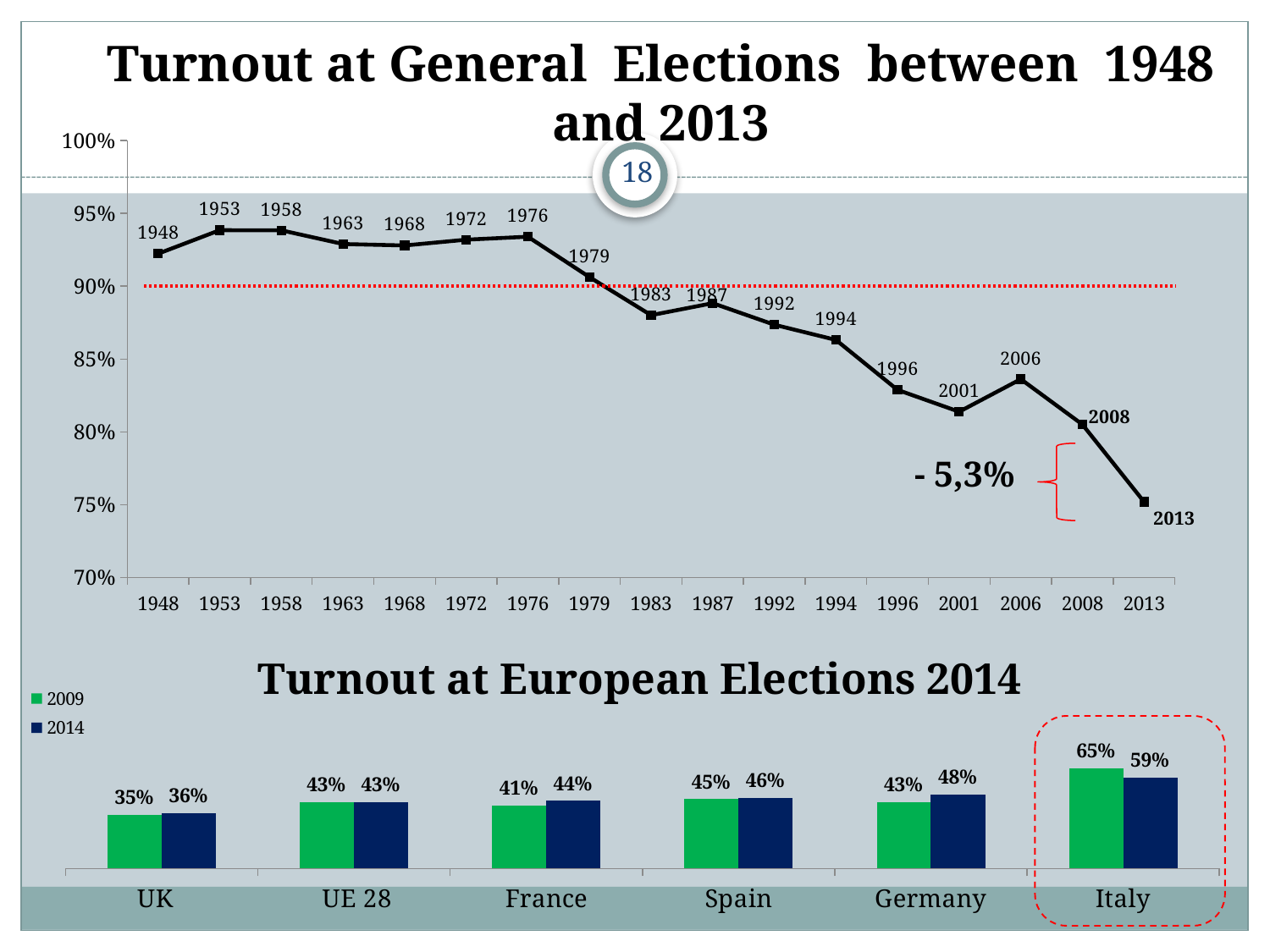
What kind of chart is 'Turnout at General Elections between 1948 and 2013'? Line chart How many series does the legend of the 'Turnout at European Elections 2014' chart list? 2 In the 'Turnout at European Elections 2014' chart, which category has the lowest 2009 value? UK In the 'Turnout at General Elections between 1948 and 2013' chart, do the values generally rise or fall from 1948 to 2013? Fall In the 'Turnout at European Elections 2014' chart, what is the difference between Italy's 2009 and 2014 values? 6% How many categories are shown in the 'Turnout at European Elections 2014' chart? 6 In the 'Turnout at European Elections 2014' chart, what is the 2014 value for Germany? 48% In the 'Turnout at General Elections between 1948 and 2013' chart, is the value for 2001 greater or less than 85%? less In the 'Turnout at European Elections 2014' chart, which is larger for France: the 2009 value or the 2014 value? 2014 In the 'Turnout at European Elections 2014' chart, what is the 2009 value for Italy? 65% How many data points are plotted in the 'Turnout at General Elections between 1948 and 2013' chart? 17 In the 'Turnout at European Elections 2014' chart, which country has the highest 2014 value? Italy